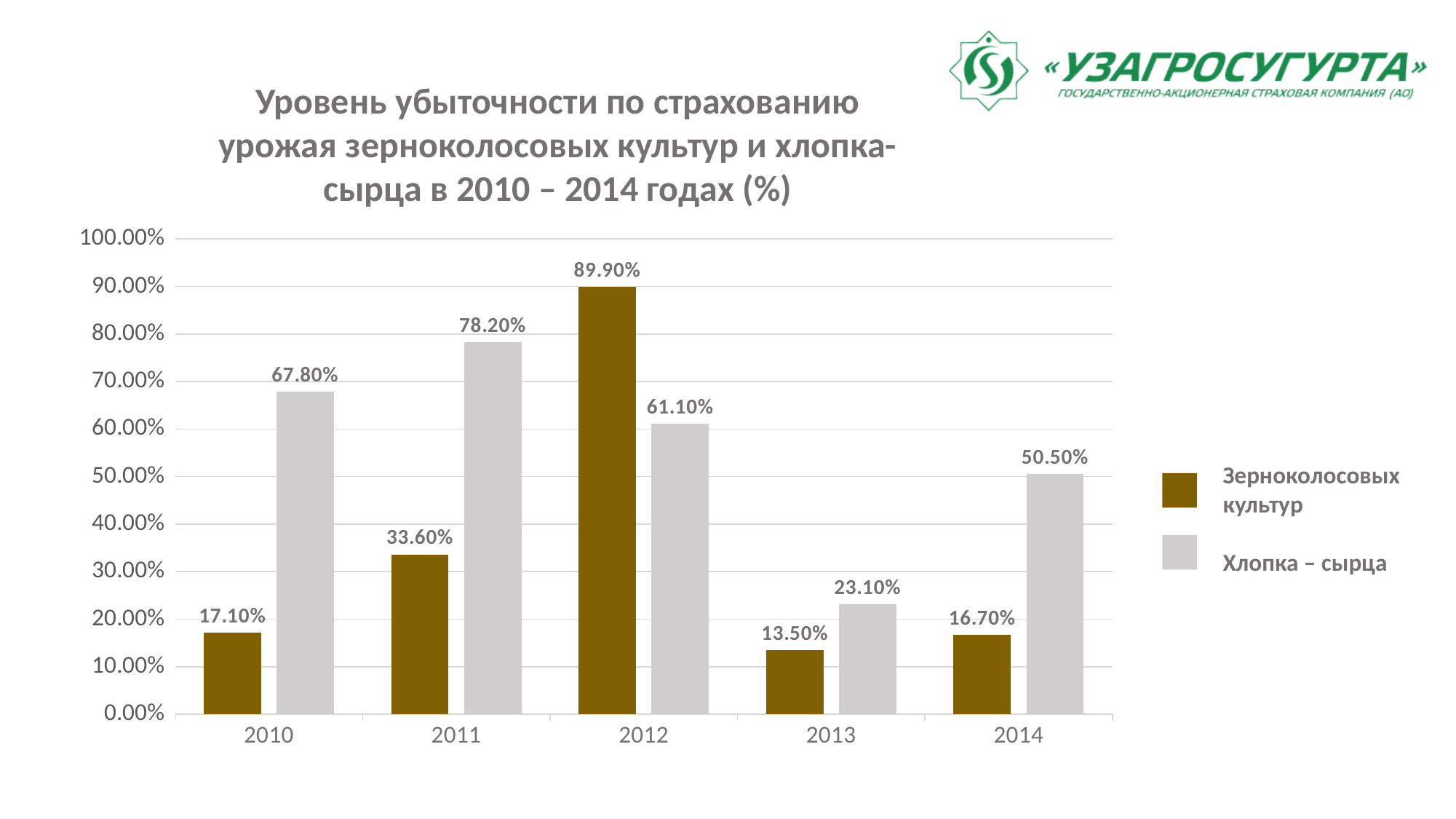
Which series has the larger value in 2012, Зерноколосовых культур or Хлопка – сырца? Зерноколосовых культур What is the value for Хлопка – сырца in 2014? 50.50% What is the difference between the Хлопка – сырца and Зерноколосовых культур values in 2010? 50.70% Which colour represents Хлопка – сырца in the legend? Grey What is the value for Зерноколосовых культур in 2012? 89.90% In which year is the value for Зерноколосовых культур lowest? 2013 What is the value for Зерноколосовых культур in 2013? 13.50% How many series does the legend list? 2 In which year is the value for Хлопка – сырца highest? 2011 What is the value for Хлопка – сырца in 2011? 78.20% How many years are shown on the x axis? 5 What kind of chart is shown on the slide? Bar chart